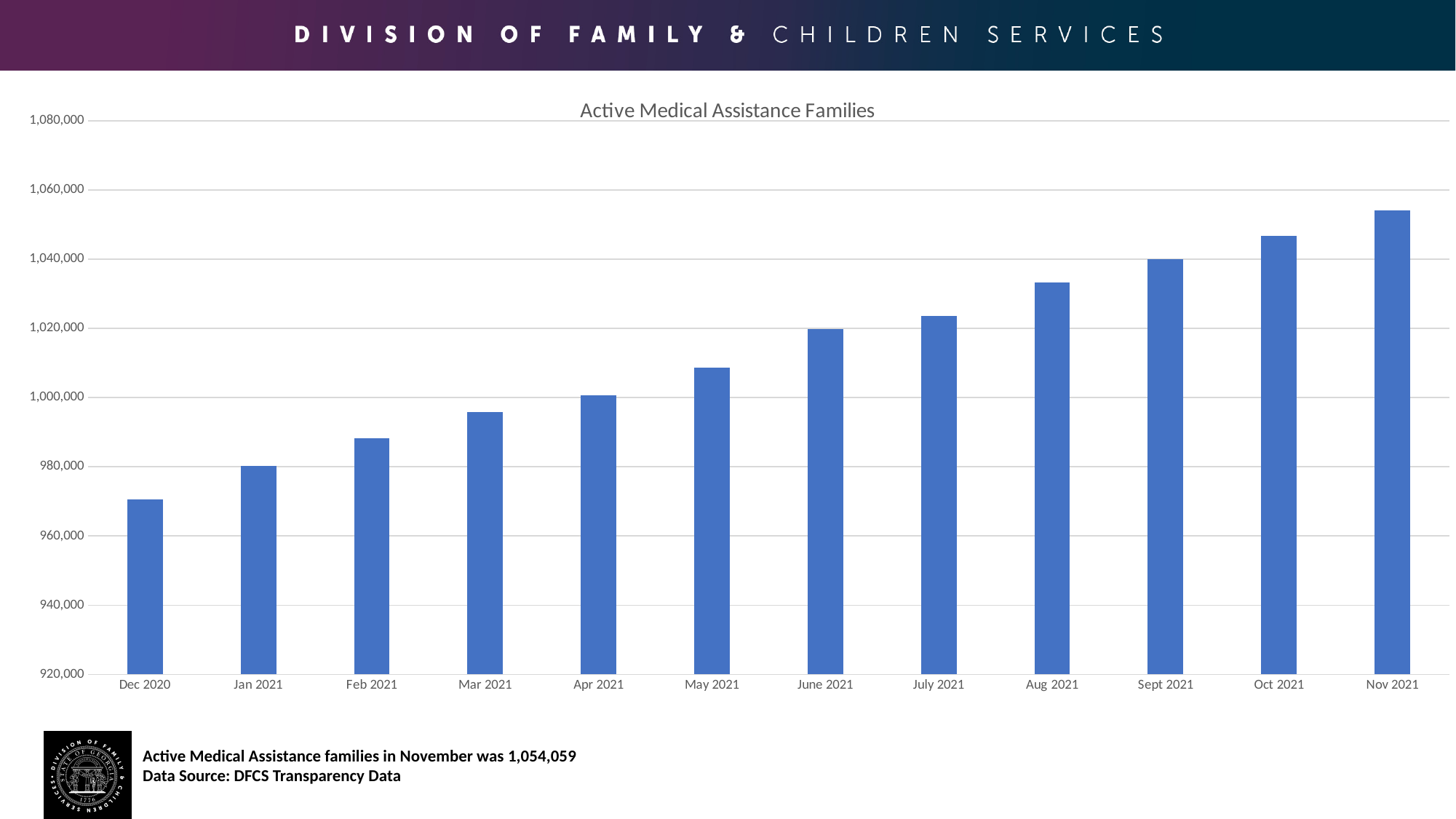
Is the value for May 2021 greater or less than 1,000,000? greater Is the value for Mar 2021 greater or less than 1,000,000? less Do the values rise or fall from Dec 2020 to Nov 2021? Rise How many active medical assistance families were there in November 2021? 1,054,059 Which month has the lowest number of active medical assistance families? Dec 2020 Is the value for Dec 2020 greater or less than 980,000? less Which is larger, the value for Apr 2021 or the value for Aug 2021? Aug 2021 How many months are shown on the x axis of the chart? 12 Which month has the highest number of active medical assistance families? Nov 2021 What type of chart is shown on the slide? Bar chart What is the title of the chart? Active Medical Assistance Families